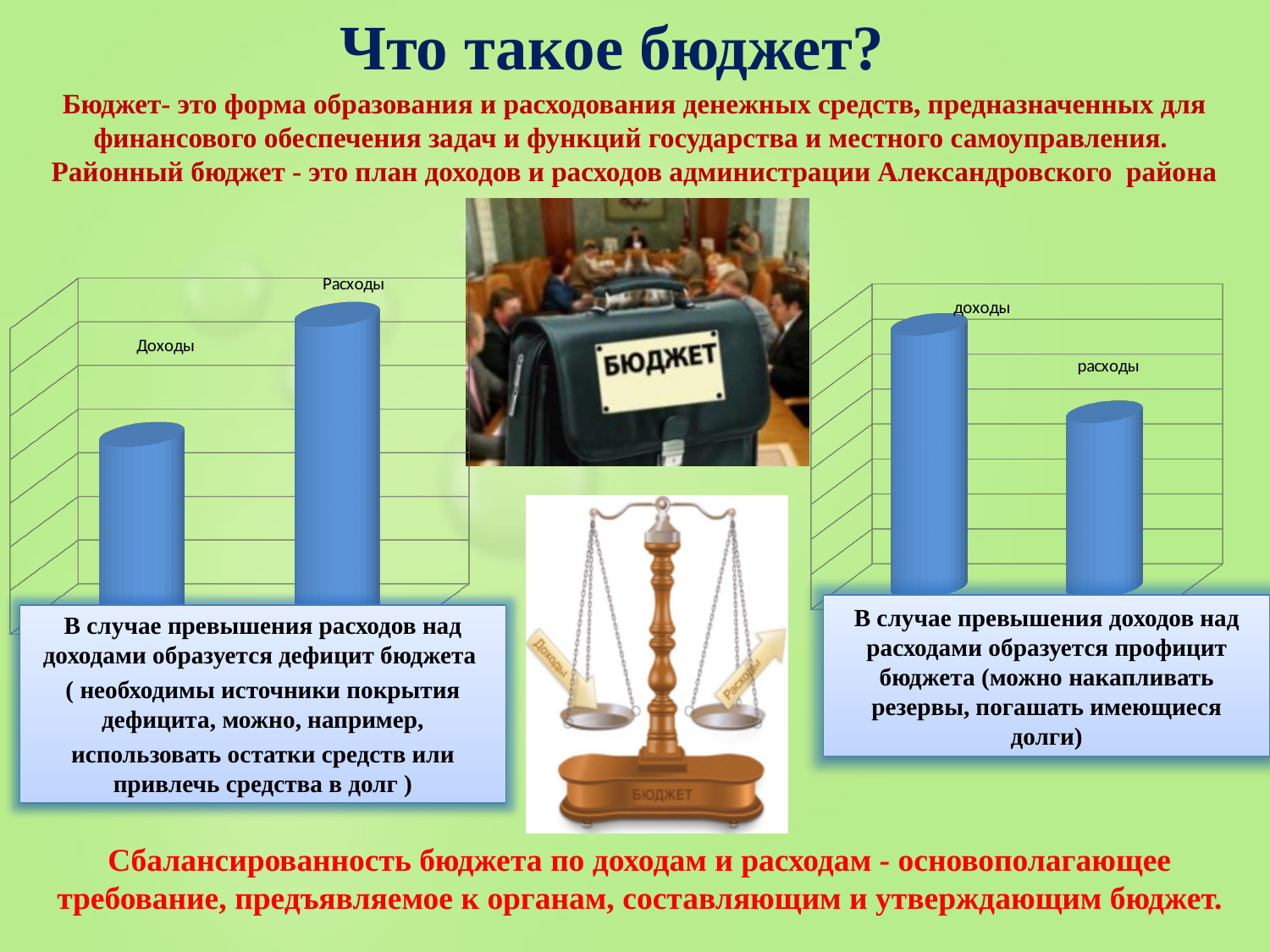
How many bars are shown on the right chart? 2 On the right chart, which category has the highest value? доходы On the left chart, which category has the taller bar, Доходы or Расходы? Расходы How many bars are shown on the left chart? 2 On the right chart, which category has the lowest value? расходы What are the two category labels on the right chart? доходы and расходы What colour are the bars on the left chart? Blue On the left chart, which category has the highest value? Расходы What kind of chart is the left chart? Bar chart What kind of chart is the right chart? Bar chart On the right chart, which category has the taller bar, доходы or расходы? доходы On the left chart, which category has the lowest value? Доходы